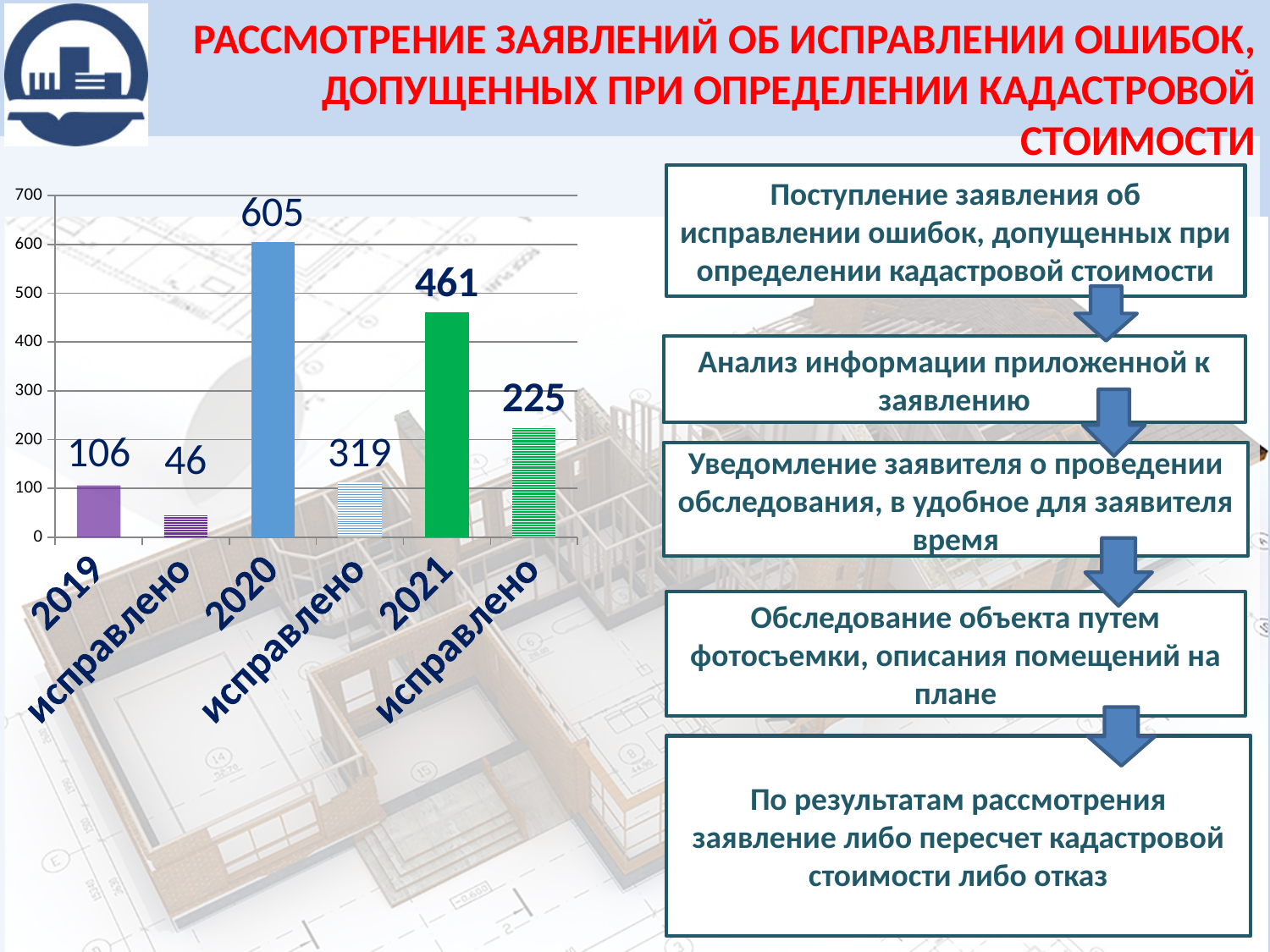
What is the value for 2019? 106 What is the value for 2020? 605 What is the value of the 'исправлено' bar that follows 2019? 46 What kind of chart is shown on the slide? bar chart How many bars are shown on the chart? 6 Which is larger, the value for 2019 or the value for 2021? 2021 What is the difference between the values for 2020 and 2021? 144 What is the lowest value shown on the chart? 46 What is the difference between the values for 2021 and 2019? 355 Which category has the highest value? 2020 What is the value for 2021? 461 What is the value of the 'исправлено' bar that follows 2021? 225